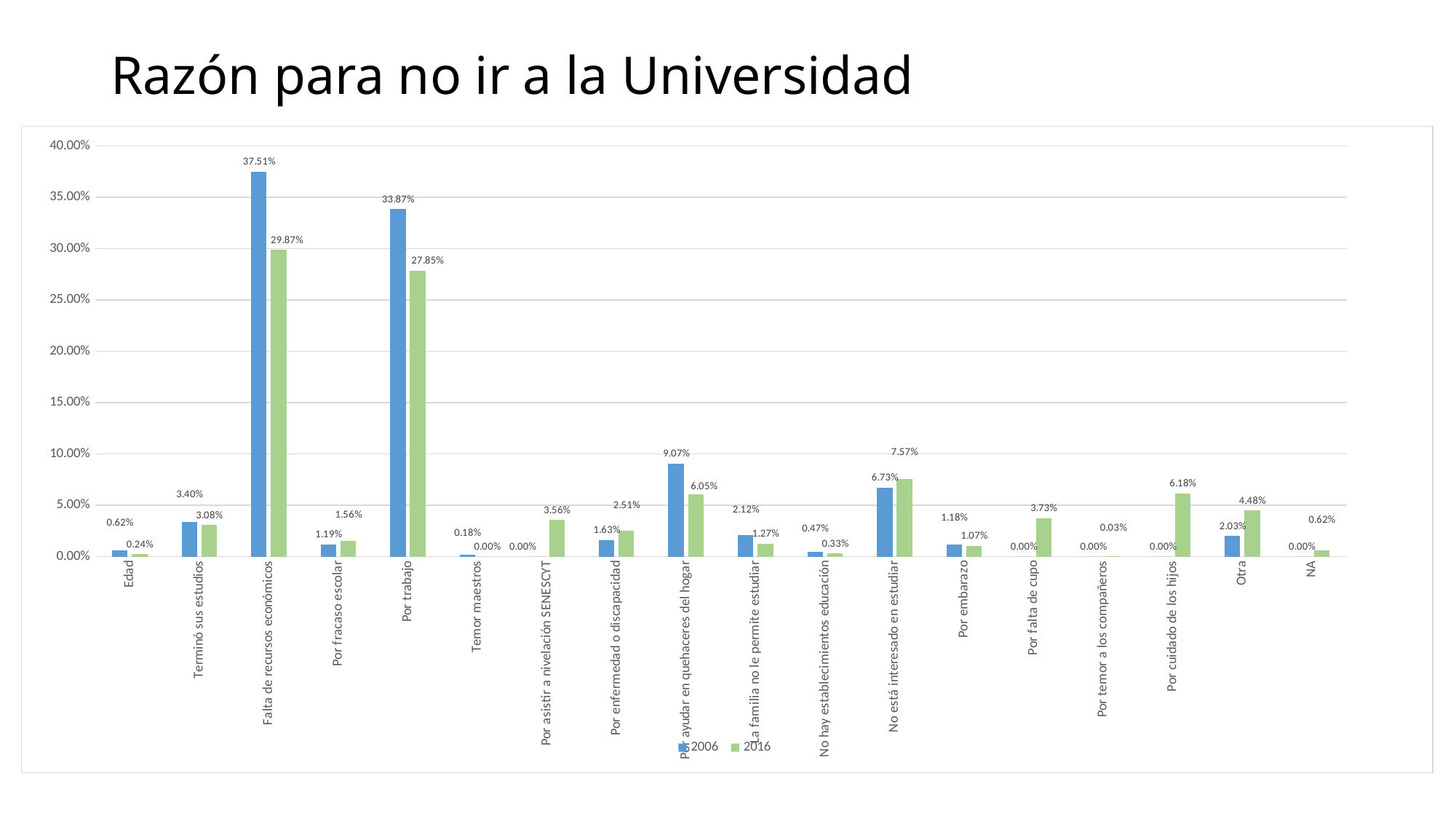
What is the difference between the 2006 and 2016 values for Por trabajo? 6.02% What is the 2016 value for Por cuidado de los hijos? 6.18% What is the 2016 value for Por trabajo? 27.85% What is the difference between the 2006 and 2016 values for Falta de recursos económicos? 7.64% What is the 2006 value for Por ayudar en quehaceres del hogar? 9.07% What kind of chart is shown on the slide? Bar chart Is the 2006 value for Por trabajo greater or less than 30.00%? greater How many series does the legend list? 2 How many categories are shown on the x axis? 18 Which category has the highest 2016 value? Falta de recursos económicos For No está interesado en estudiar, which year has the larger value, 2006 or 2016? 2016 What is the 2006 value for Falta de recursos económicos? 37.51%